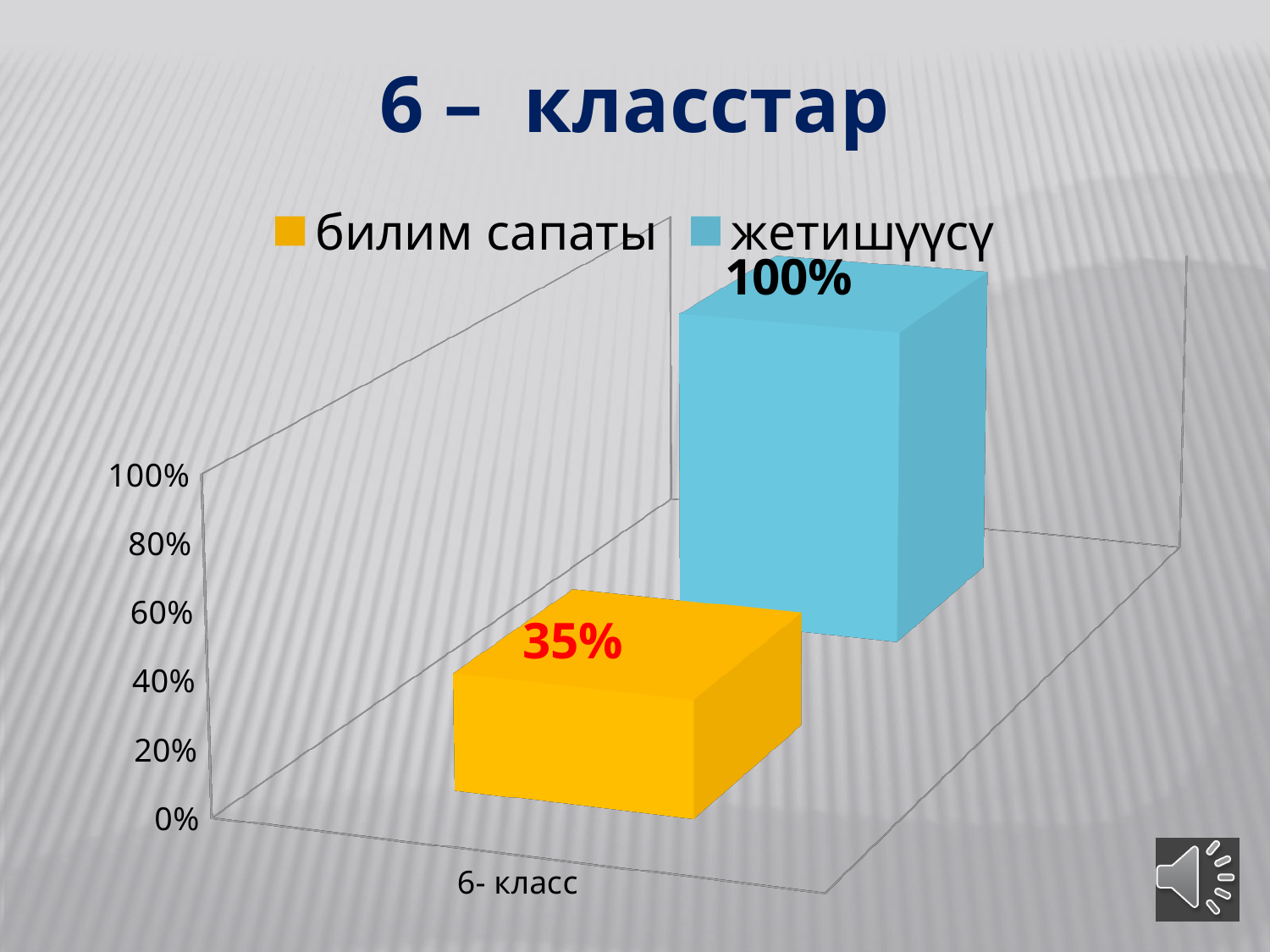
What is the value for жетишүүсү for 6- класс? 100% What colour is the bar for жетишүүсү? blue Is the value for билим сапаты greater or less than the value for жетишүүсү? less What kind of chart is shown on the slide? bar chart How many categories are shown on the x axis? 1 What is the difference between жетишүүсү and билим сапаты for 6- класс? 65% What is the value for билим сапаты for 6- класс? 35% Which series has the lower value for 6- класс? билим сапаты Is the value for билим сапаты greater or less than 40%? less How many series does the legend list? 2 Which series has the higher value for 6- класс? жетишүүсү Is the value for жетишүүсү greater or less than 80%? greater